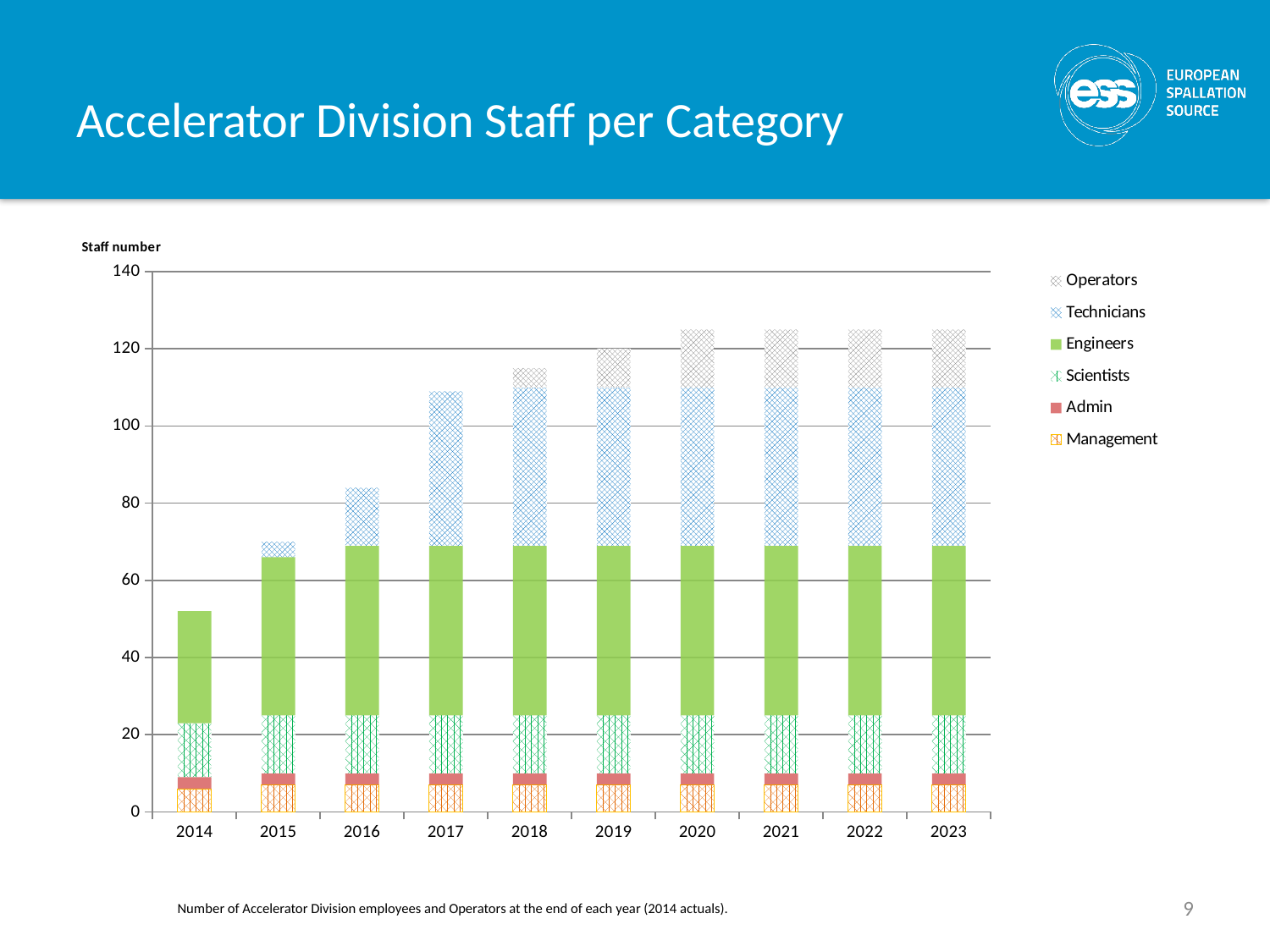
Which year has the lowest total staff number? 2014 What kind of chart is shown on the slide? stacked bar chart Is the total staff number for 2016 greater or less than 100? less Is the total staff number for 2014 greater or less than 60? less Do the total staff numbers rise or fall from 2014 to 2017? rise Is the total staff number for 2020 greater or less than 120? greater How many years are shown along the x axis of the chart? 10 What is the label on the vertical axis of the chart? Staff number How many series does the chart legend list? 6 Which year has the larger total staff number, 2014 or 2015? 2015